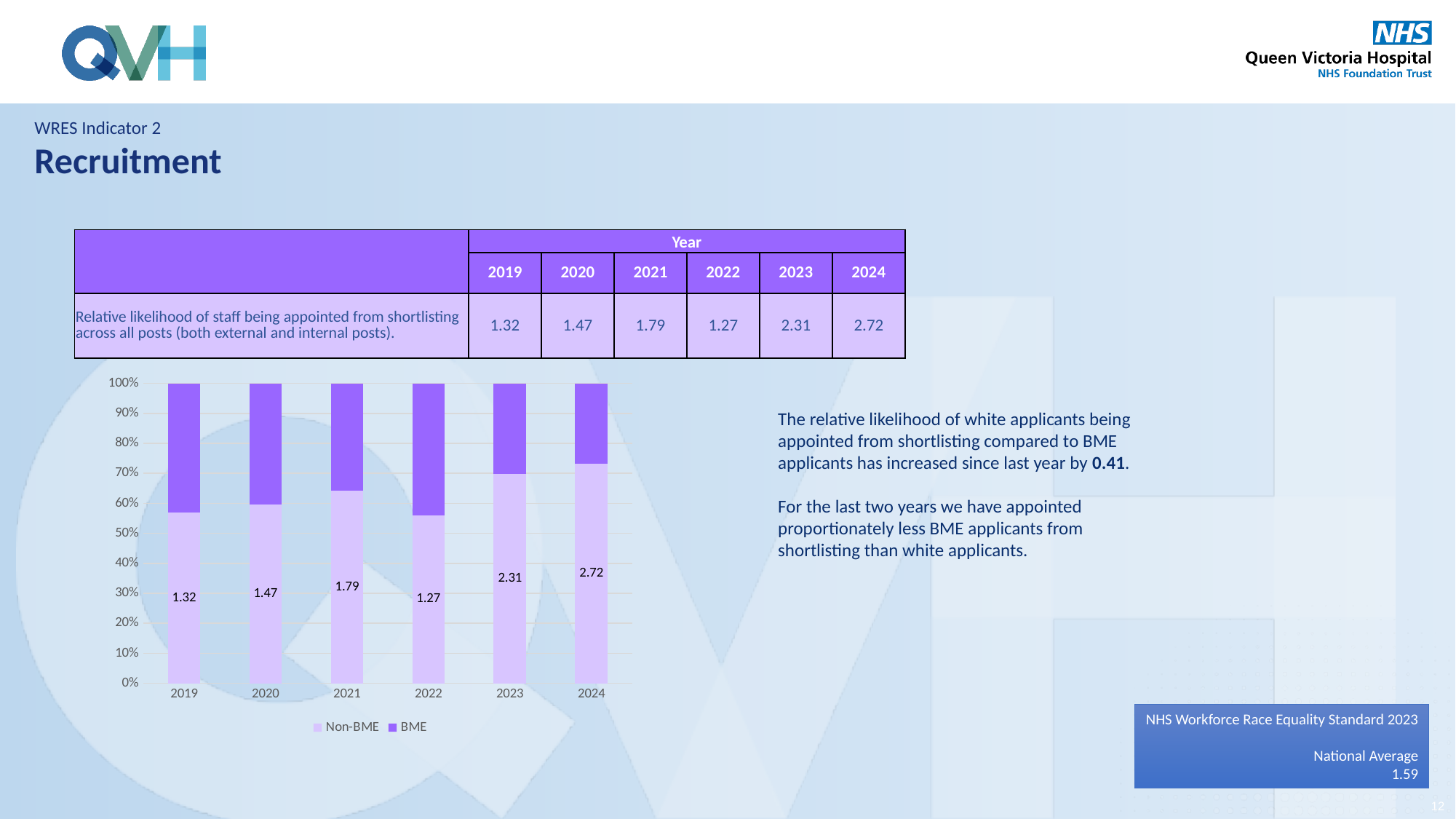
Is the Non-BME share of the 2024 bar greater or less than 70%? greater Does the Non-BME share of the bars rise or fall from 2022 to 2024? Rise Is the Non-BME share of the 2022 bar greater or less than 60%? less Which year has the highest data label on its bar? 2024 How many years are shown on the x axis of the chart? 6 What data label is shown on the 2022 bar? 1.27 Which year has the lowest data label on its bar? 2022 Which year has the larger data label, 2020 or 2021? 2021 What data label is shown on the 2024 bar? 2.72 What type of chart is shown on the slide? Stacked bar chart How many series does the chart legend list? 2 What is the difference between the data labels for 2024 and 2023? 0.41